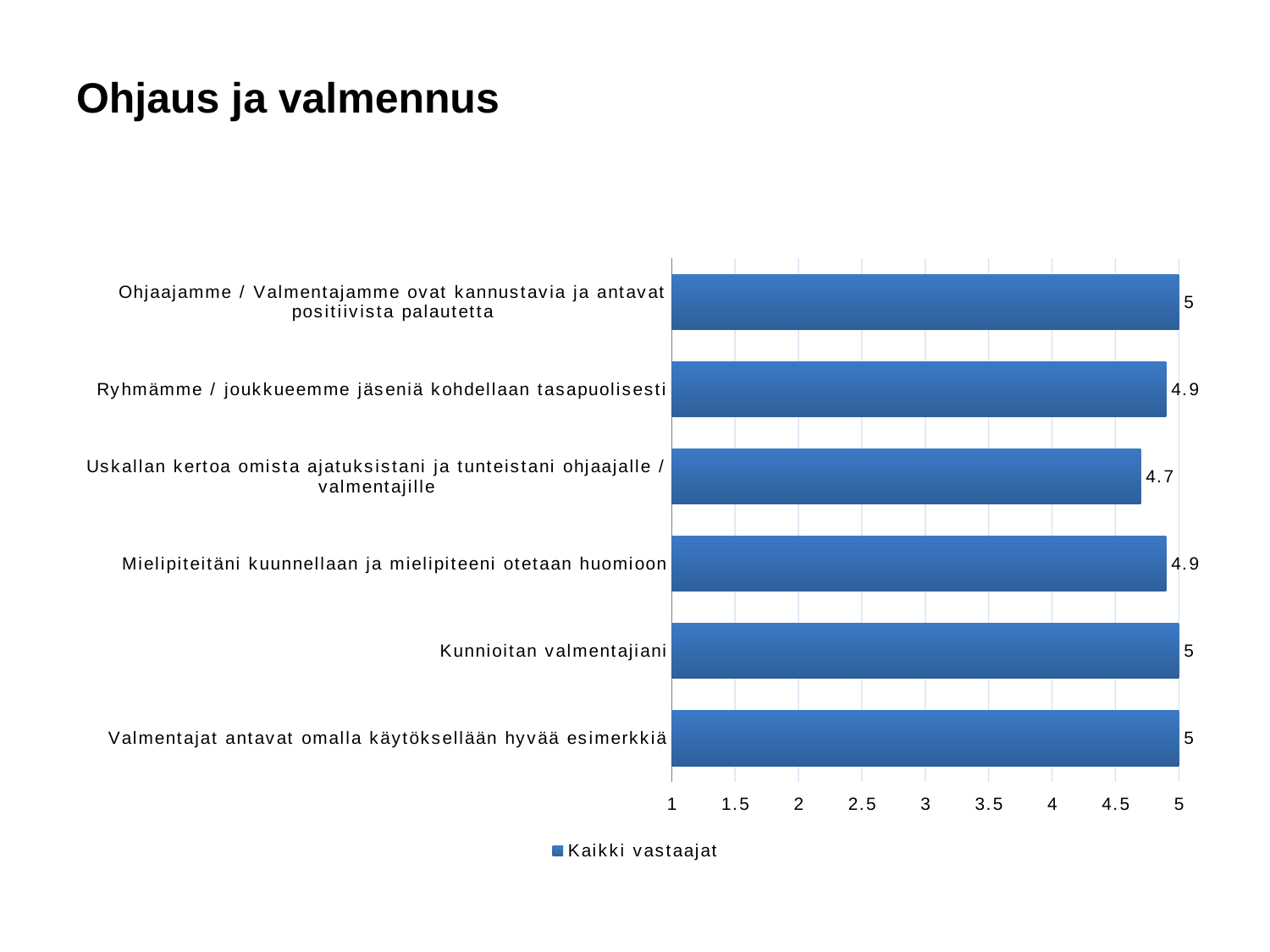
Is the value for "Uskallan kertoa omista ajatuksistani ja tunteistani ohjaajalle / valmentajille" greater or less than 4.5? greater What is the value for "Kunnioitan valmentajiani"? 5 What is the value for "Mielipiteitäni kuunnellaan ja mielipiteeni otetaan huomioon"? 4.9 Which category has the lowest value? Uskallan kertoa omista ajatuksistani ja tunteistani ohjaajalle / valmentajille How many series does the legend list? 1 What is the name of the series shown in the legend? Kaikki vastaajat What is the value for "Uskallan kertoa omista ajatuksistani ja tunteistani ohjaajalle / valmentajille"? 4.7 What kind of chart is shown on the slide? bar chart How many categories are shown in the chart? 6 What is the value for "Ryhmämme / joukkueemme jäseniä kohdellaan tasapuolisesti"? 4.9 What is the difference between the value for "Kunnioitan valmentajiani" and the value for "Uskallan kertoa omista ajatuksistani ja tunteistani ohjaajalle / valmentajille"? 0.3 Which is larger: the value for "Valmentajat antavat omalla käytöksellään hyvää esimerkkiä" or the value for "Uskallan kertoa omista ajatuksistani ja tunteistani ohjaajalle / valmentajille"? Valmentajat antavat omalla käytöksellään hyvää esimerkkiä